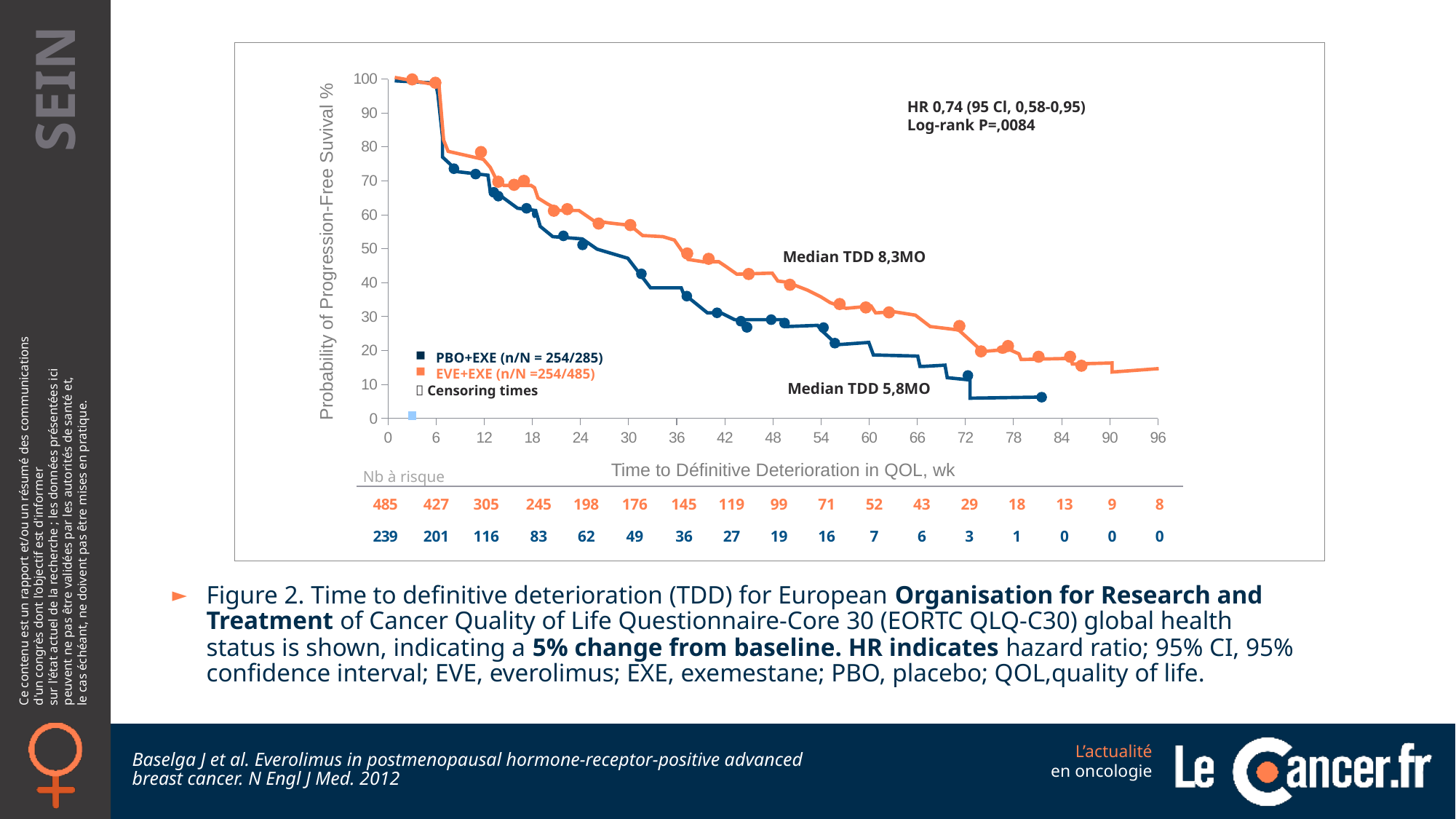
Which group has the higher probability of progression-free survival at week 48? EVE+EXE How many treatment groups are plotted on the chart? 2 What is the label of the x axis? Time to Définitive Deterioration in QOL, wk What is the median TDD for the EVE+EXE group? 8,3MO How many EVE+EXE patients were at risk at week 0? 485 What is the difference between the number of EVE+EXE and PBO+EXE patients at risk at week 0? 246 What hazard ratio (HR) is printed on the chart? 0,74 (95 CI, 0,58-0,95) Is the EVE+EXE curve at week 12 greater or less than 70? greater What kind of chart is shown on the slide? line chart What is the log-rank P value shown on the chart? ,0084 How many PBO+EXE patients were at risk at week 24? 62 What is the median TDD for the PBO+EXE group? 5,8MO